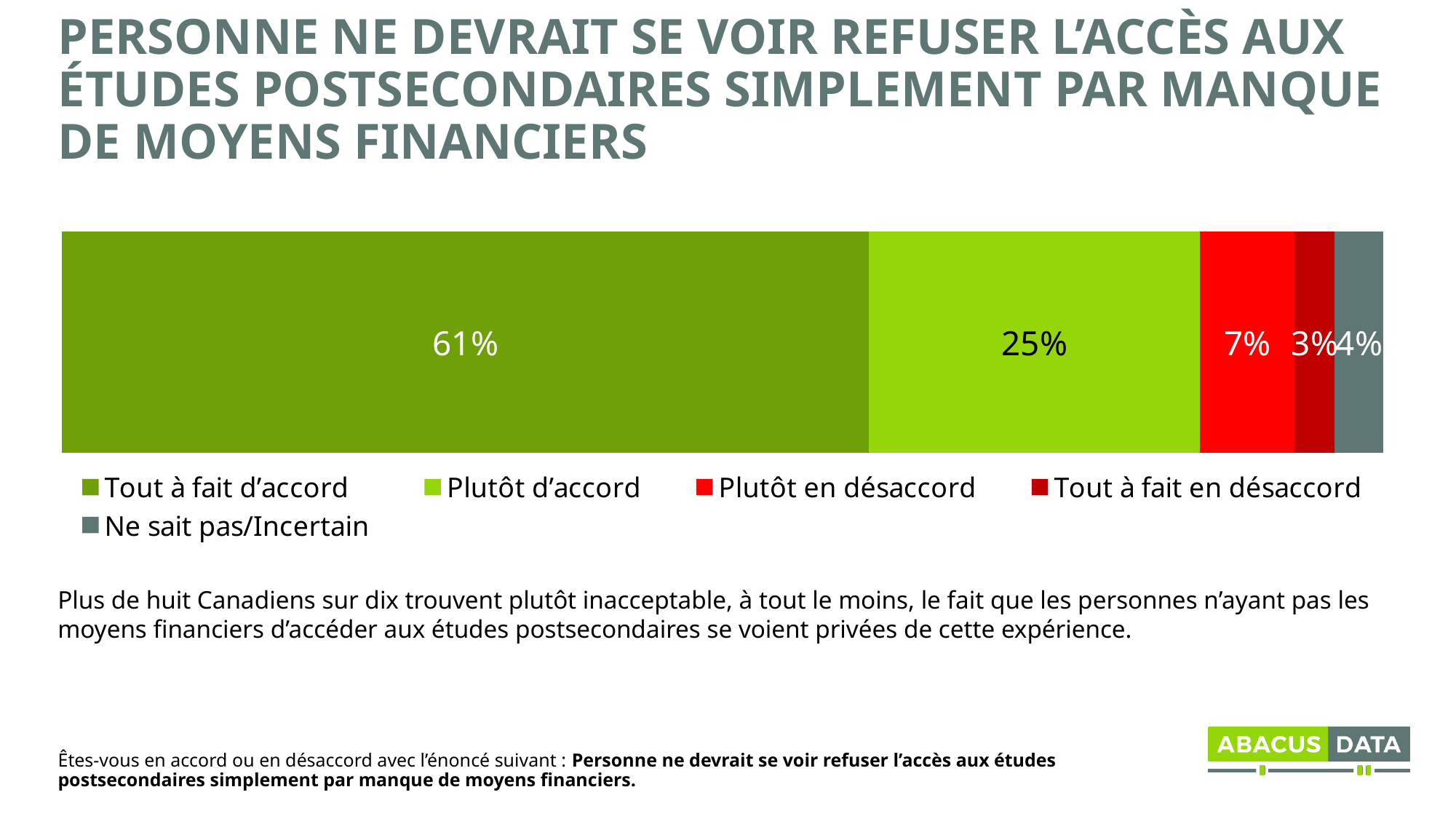
What percentage of respondents answered "Tout à fait d'accord"? 61% Which response category has the smallest share? Tout à fait en désaccord What percentage of respondents answered "Plutôt en désaccord"? 7% Which is larger, the share for "Plutôt en désaccord" or for "Ne sait pas/Incertain"? Plutôt en désaccord What is the difference between the "Tout à fait d'accord" and "Plutôt d'accord" shares? 36 percentage points What type of chart is shown on the slide? Stacked bar chart What percentage of respondents answered "Tout à fait en désaccord"? 3% What percentage of respondents answered "Plutôt d'accord"? 25% How many response categories does the legend list? 5 Which response category has the largest share? Tout à fait d'accord What is the combined share of "Tout à fait d'accord" and "Plutôt d'accord"? 86% What percentage of respondents answered "Ne sait pas/Incertain"? 4%